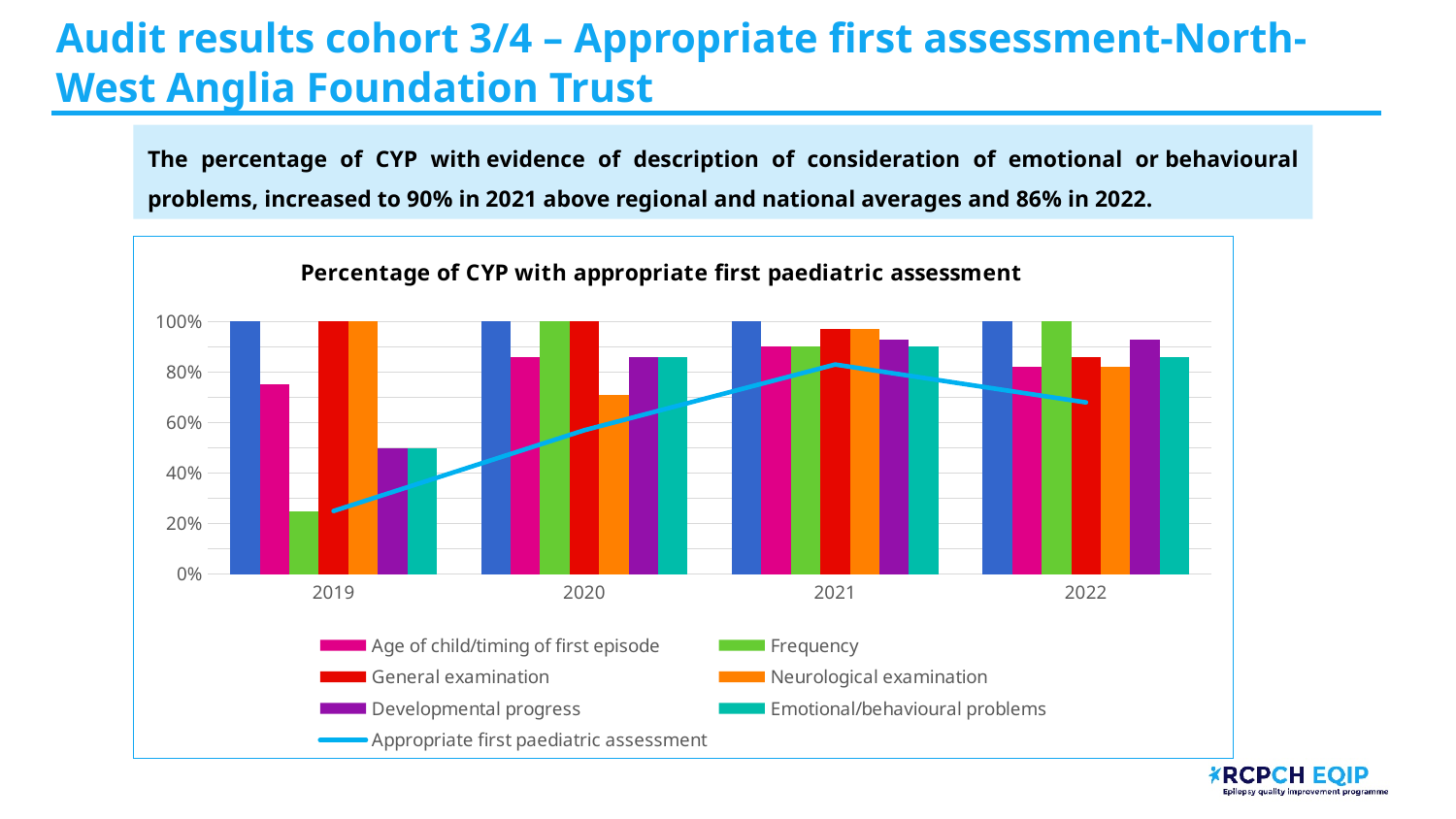
Which series has the lowest bar in 2019? Frequency What is the value for Frequency in 2022? 100% What kind of chart is shown on the slide? combination bar and line chart How many series does the chart legend list? 7 Is the value of the Appropriate first paediatric assessment line in 2022 greater or less than 80%? less Does the Appropriate first paediatric assessment line rise or fall from 2019 to 2021? rise How many years are shown on the x axis of the chart? 4 Is the value for Neurological examination in 2020 greater or less than 80%? less What is the value for Frequency in 2020? 100% What is the title of the chart? Percentage of CYP with appropriate first paediatric assessment Is the value for Frequency in 2019 greater or less than 40%? less What is the value for General examination in 2019? 100%